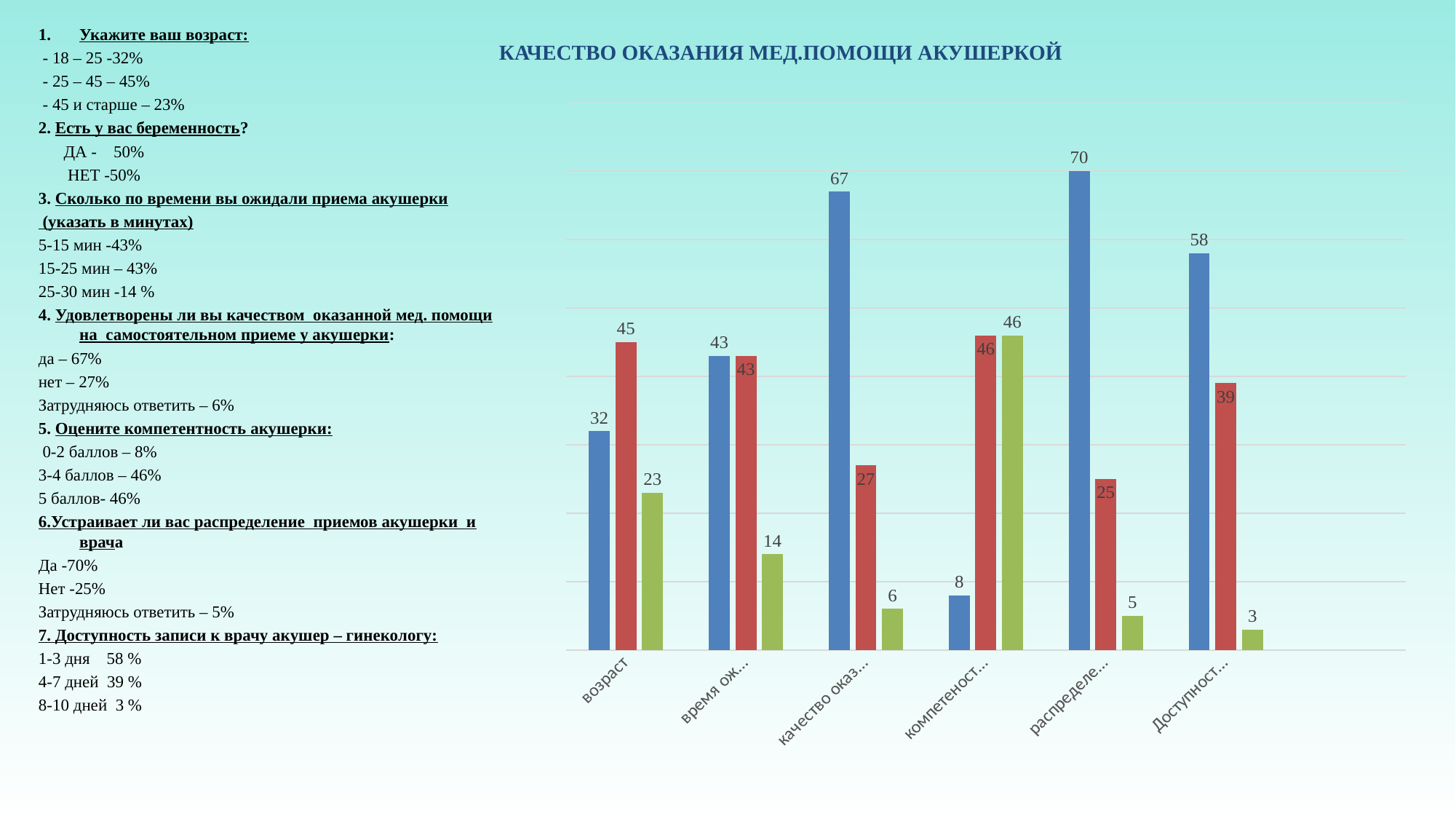
What is the value of the green bar for the category 'возраст'? 23 What kind of chart is shown on the slide? bar chart What is the sum of the three bars for the category 'возраст'? 100 Which is larger: the blue bar in the third category from the left or the blue bar in the sixth (rightmost) category? the third category (67) What is the lowest value shown on the chart? 3 What is the title of the chart? КАЧЕСТВО ОКАЗАНИЯ МЕД.ПОМОЩИ АКУШЕРКОЙ What is the value of the blue bar for the category 'возраст'? 32 What is the value of the red bar for the category 'возраст'? 45 How many bars are shown for each category? 3 For the category 'возраст', what is the difference between the red bar and the blue bar? 13 How many categories are shown on the x axis? 6 What is the highest value shown on the chart? 70